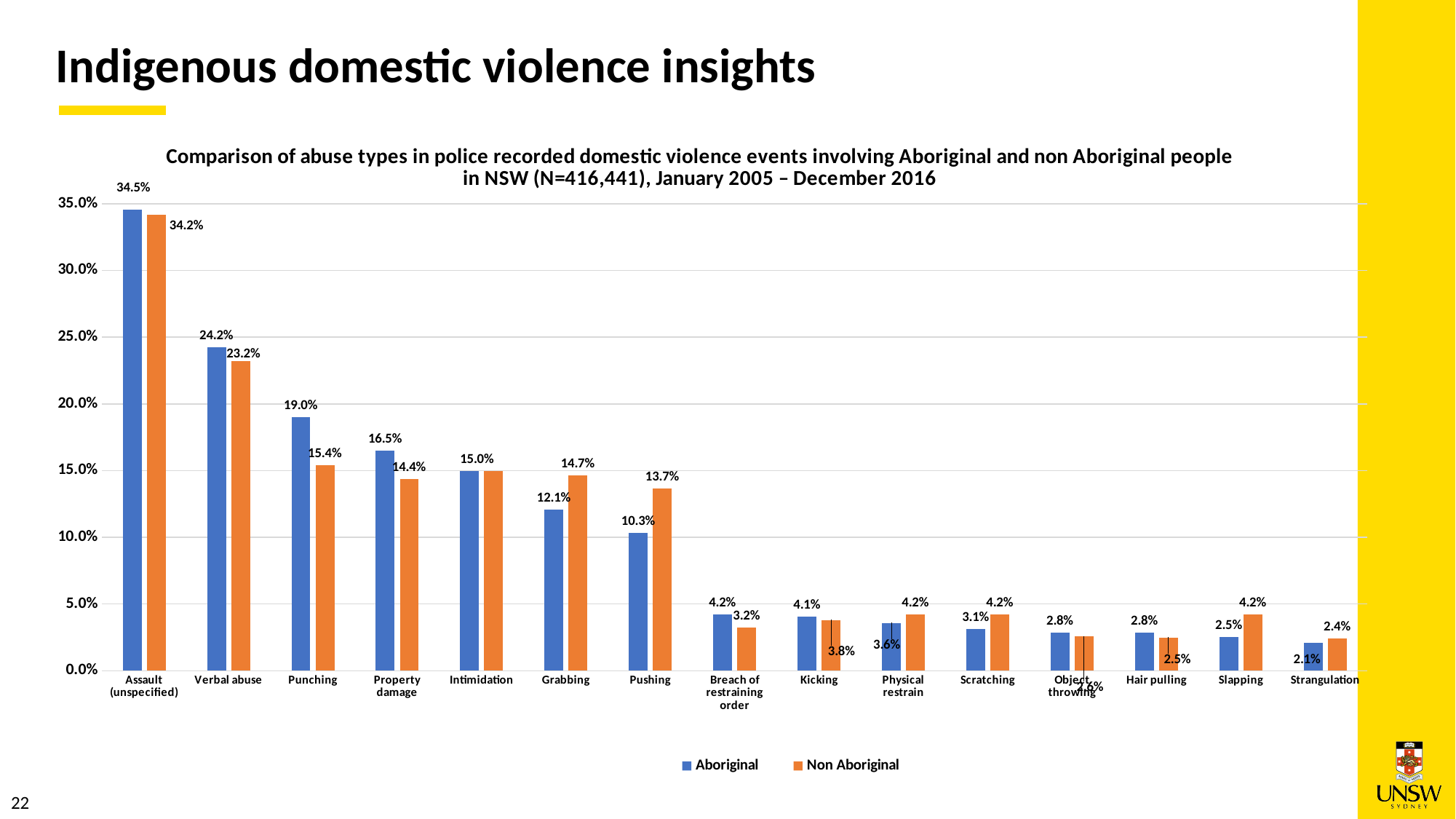
Which abuse type has the highest Aboriginal value? Assault (unspecified) What is the Aboriginal value for Punching? 19.0% What is the difference between the Aboriginal and Non Aboriginal values for Punching? 3.6% Which abuse type has the lowest Aboriginal value? Strangulation What is the Non Aboriginal value for Pushing? 13.7% What is the difference between the Aboriginal and Non Aboriginal values for Verbal abuse? 1.0% What kind of chart is shown on the slide? Bar chart How many abuse types are shown on the x axis? 15 For Grabbing, which series has the larger value, Aboriginal or Non Aboriginal? Non Aboriginal Is the Aboriginal value for Property damage greater or less than 15.0%? greater What is the Non Aboriginal value for Slapping? 4.2% How many series does the legend list? 2